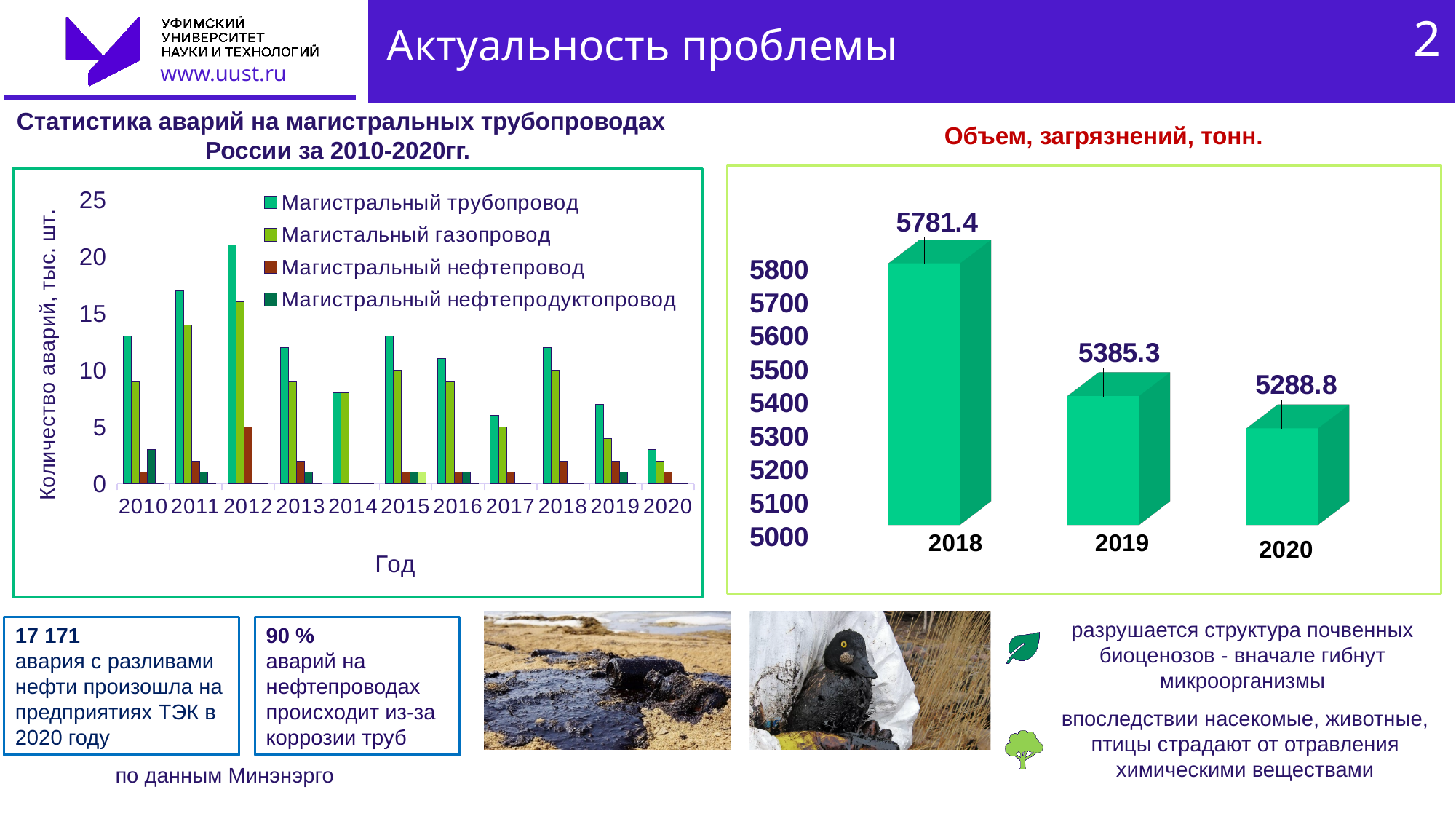
What kind of chart is the left chart (Статистика аварий на магистральных трубопроводах России за 2010-2020гг.)? bar chart On the left chart (Статистика аварий на магистральных трубопроводах России за 2010-2020гг.), is the value for Магистральный трубопровод in 2012 greater or less than 15? greater On the left chart (Статистика аварий на магистральных трубопроводах России за 2010-2020гг.), in which year is the value for Магистральный трубопровод highest? 2012 On the chart titled 'Объем, загрязнений, тонн.', how many years are shown? 3 On the chart titled 'Объем, загрязнений, тонн.', what is the value for 2020? 5288.8 On the chart titled 'Объем, загрязнений, тонн.', which year has the lowest value? 2020 On the left chart (Статистика аварий на магистральных трубопроводах России за 2010-2020гг.), is the value for Магистральный трубопровод in 2020 greater or less than 5? less On the chart titled 'Объем, загрязнений, тонн.', do the values rise or fall from 2018 to 2020? fall On the left chart (Статистика аварий на магистральных трубопроводах России за 2010-2020гг.), how many series does the legend list? 4 On the left chart (Статистика аварий на магистральных трубопроводах России за 2010-2020гг.), how many years are shown on the x axis? 11 On the chart titled 'Объем, загрязнений, тонн.', what is the difference between the 2018 and 2019 values? 396.1 On the chart titled 'Объем, загрязнений, тонн.', what is the value for 2018? 5781.4